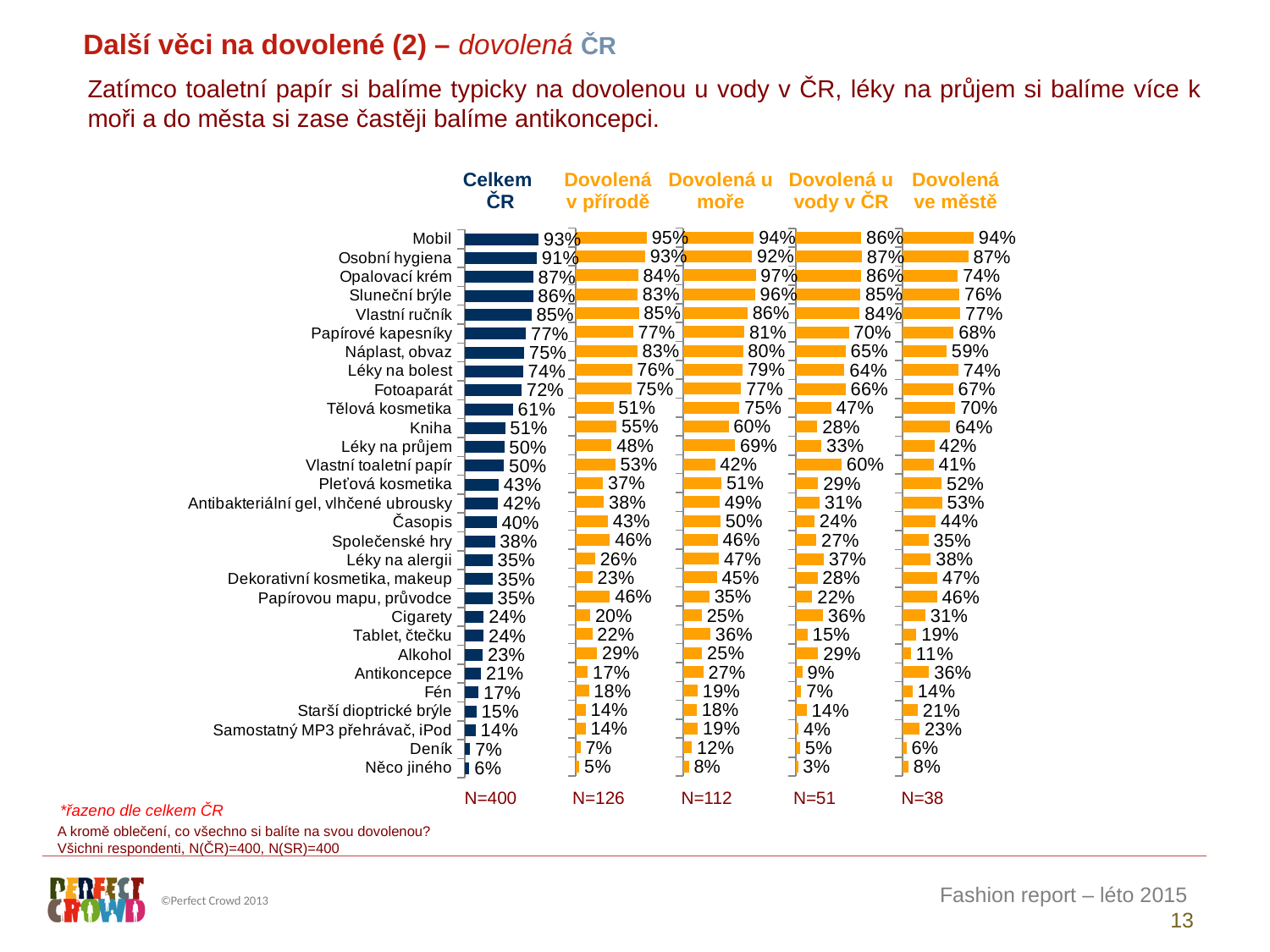
How many categories are listed in the Celkem ČR chart? 29 In the Celkem ČR chart, what is the value for Mobil? 93% In the Dovolená u moře chart, which category has the highest value? Opalovací krém What kind of chart is used for Dovolená ve městě? bar chart In the Dovolená v přírodě chart, what is the value for Náplast, obvaz? 83% For Léky na průjem, which chart shows the larger value: Dovolená u moře or Dovolená v přírodě? Dovolená u moře In the Celkem ČR chart, is the value for Tělová kosmetika greater or less than 50%? greater In the Dovolená u vody v ČR chart, what is the value for Fén? 7% In the Dovolená ve městě chart, what is the value for Antikoncepce? 36% In the Celkem ČR chart, which category has the lowest value? Něco jiného In the Dovolená u moře chart, what is the value for Opalovací krém? 97% For Vlastní toaletní papír, what is the difference between the Dovolená u vody v ČR value and the Dovolená u moře value? 18 percentage points